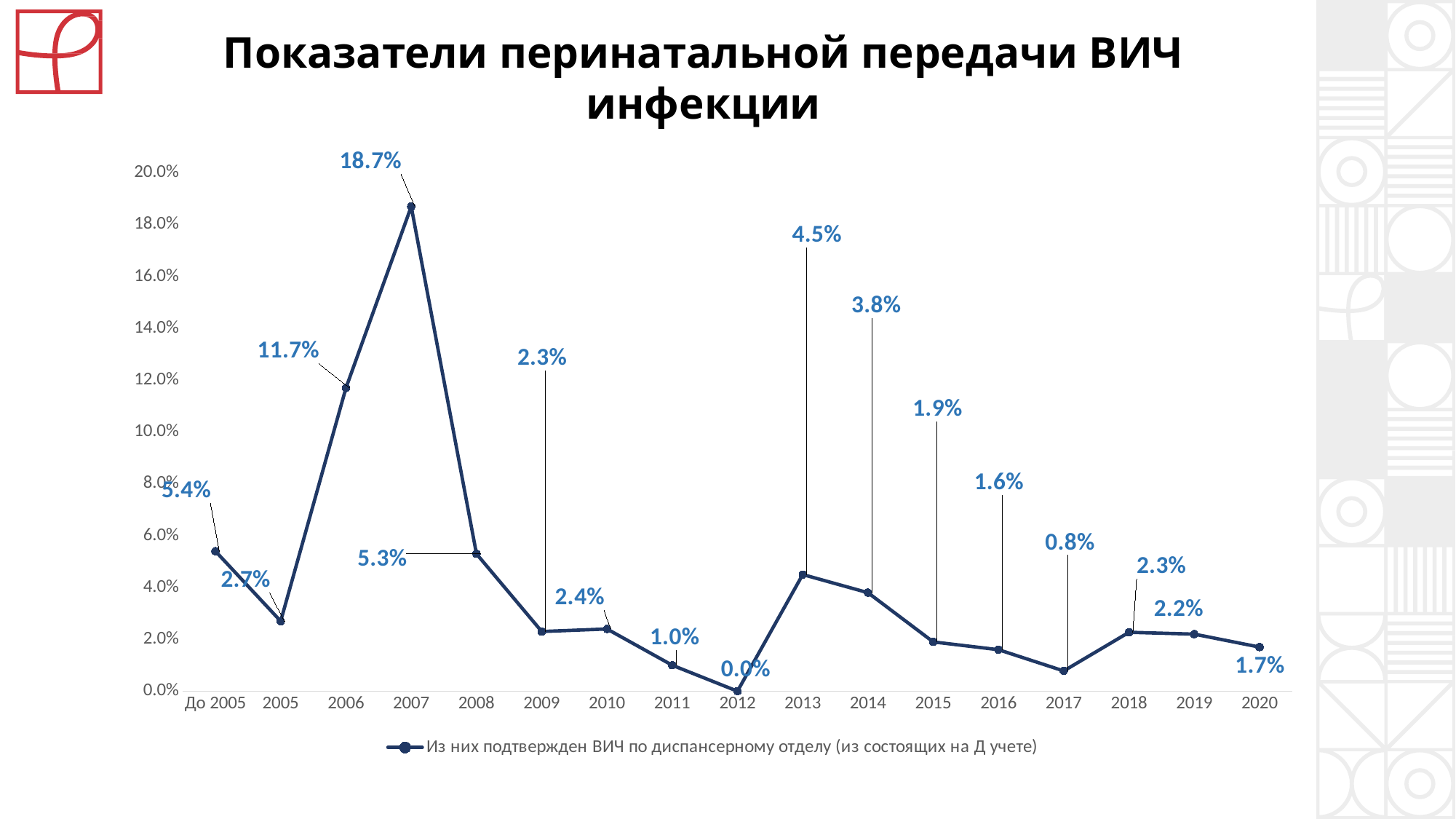
What type of chart is shown on the slide? line chart What is the value for 2007? 18.7% What is the value for 2020? 1.7% How many series does the legend list? 1 What is the value for 2013? 4.5% Do the values rise or fall from 2013 to 2017? fall Which year has the highest value? 2007 What is the difference between the values for 2007 and 2006? 7.0% Which year has the lowest value? 2012 What is the value for 'До 2005'? 5.4% Which is larger, the value for 2014 or the value for 2015? 2014 How many data points are plotted on the chart? 17